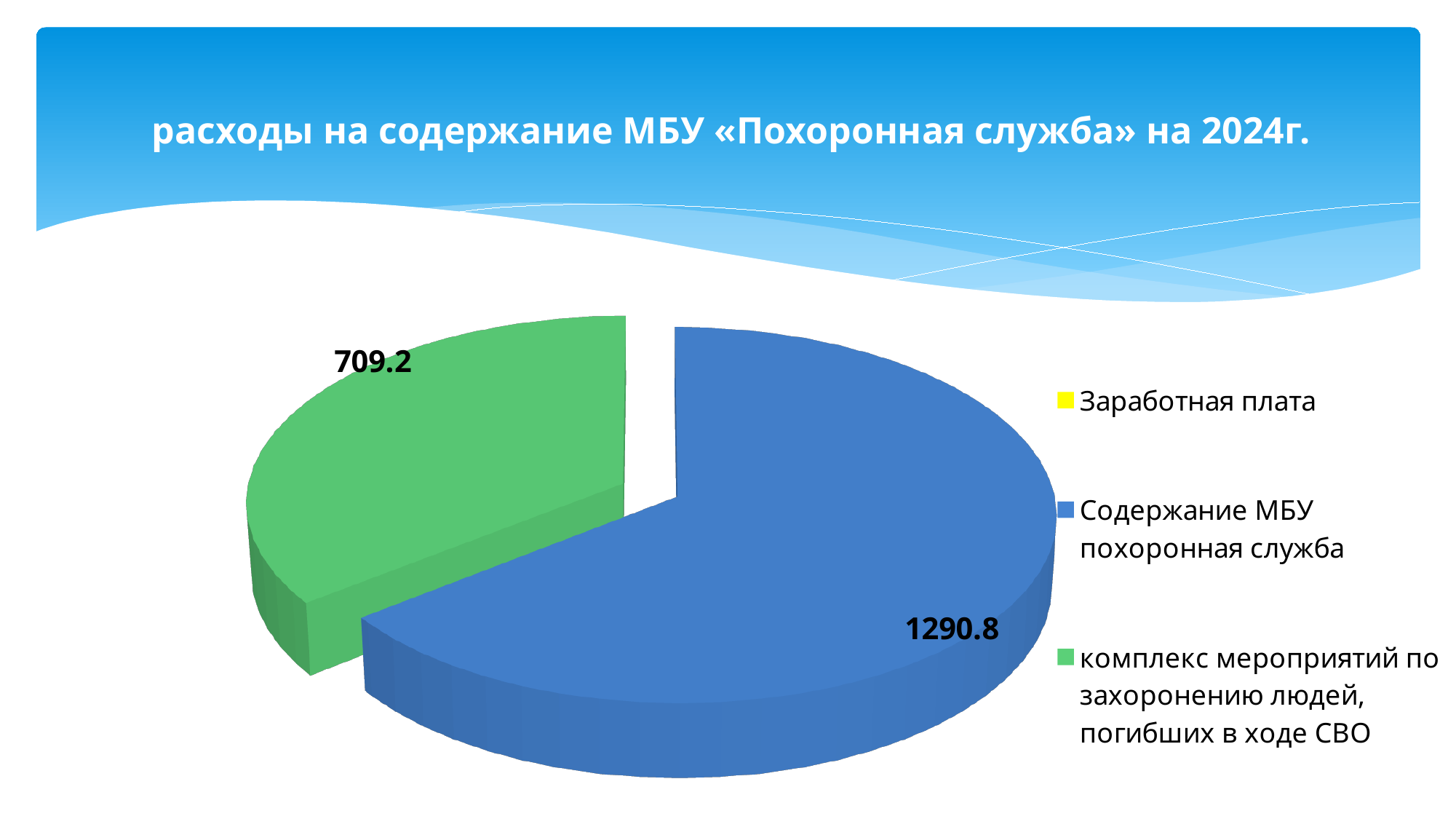
How many entries does the legend list? 3 What kind of chart is shown on the slide? pie chart What is the title of the chart on the slide? расходы на содержание МБУ «Похоронная служба» на 2024г. What is the value shown for the slice "комплекс мероприятий по захоронению людей, погибших в ходе СВО"? 709.2 How many slices with data labels are visible in the pie chart? 2 What colour is the slice labelled 1290.8? blue What is the difference between the values 1290.8 and 709.2 shown on the pie chart? 581.6 Which category has the largest slice in the pie chart? Содержание МБУ похоронная служба What is the value shown for the slice "Содержание МБУ похоронная служба"? 1290.8 Which is larger: the value for "Содержание МБУ похоронная служба" or the value for "комплекс мероприятий по захоронению людей, погибших в ходе СВО"? Содержание МБУ похоронная служба Which of the labelled slices has the smallest value? комплекс мероприятий по захоронению людей, погибших в ходе СВО